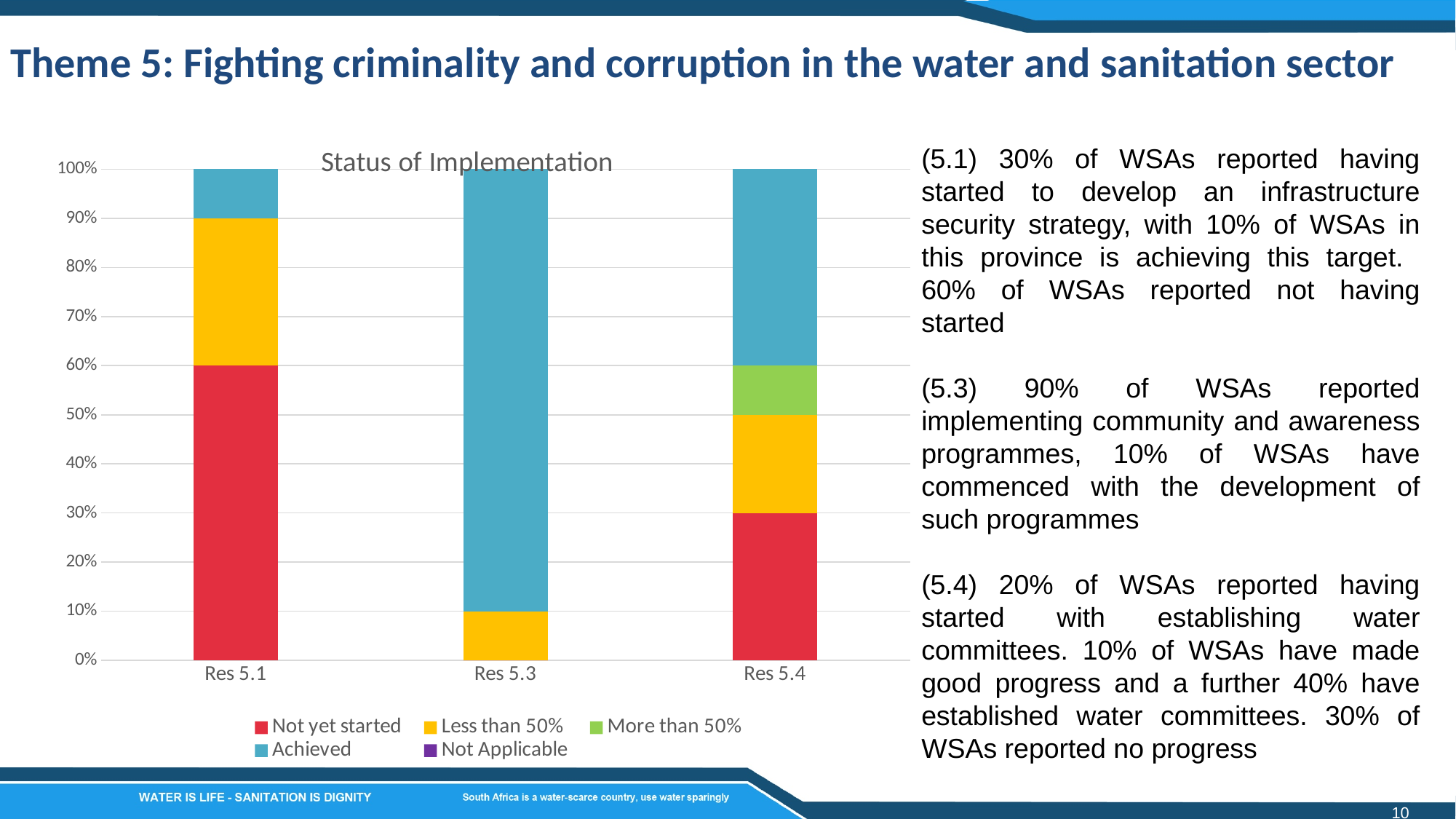
How many series does the chart legend list? 5 What is the 'Not yet started' value for Res 5.4? 30% Which category has the largest 'Not yet started' share? Res 5.1 What is the total height of the stacked bar for Res 5.1? 100% How many categories are shown on the x axis of the chart? 3 What kind of chart is shown on the slide? Stacked bar chart Is the 'Achieved' share larger for Res 5.3 or for Res 5.1? Res 5.3 What is the 'Less than 50%' value for Res 5.3? 10% What is the title of the chart? Status of Implementation Is the 'Achieved' value for Res 5.3 greater or less than 50%? greater Which category has the smallest 'Not yet started' share? Res 5.3 What is the 'Not yet started' value for Res 5.1? 60%